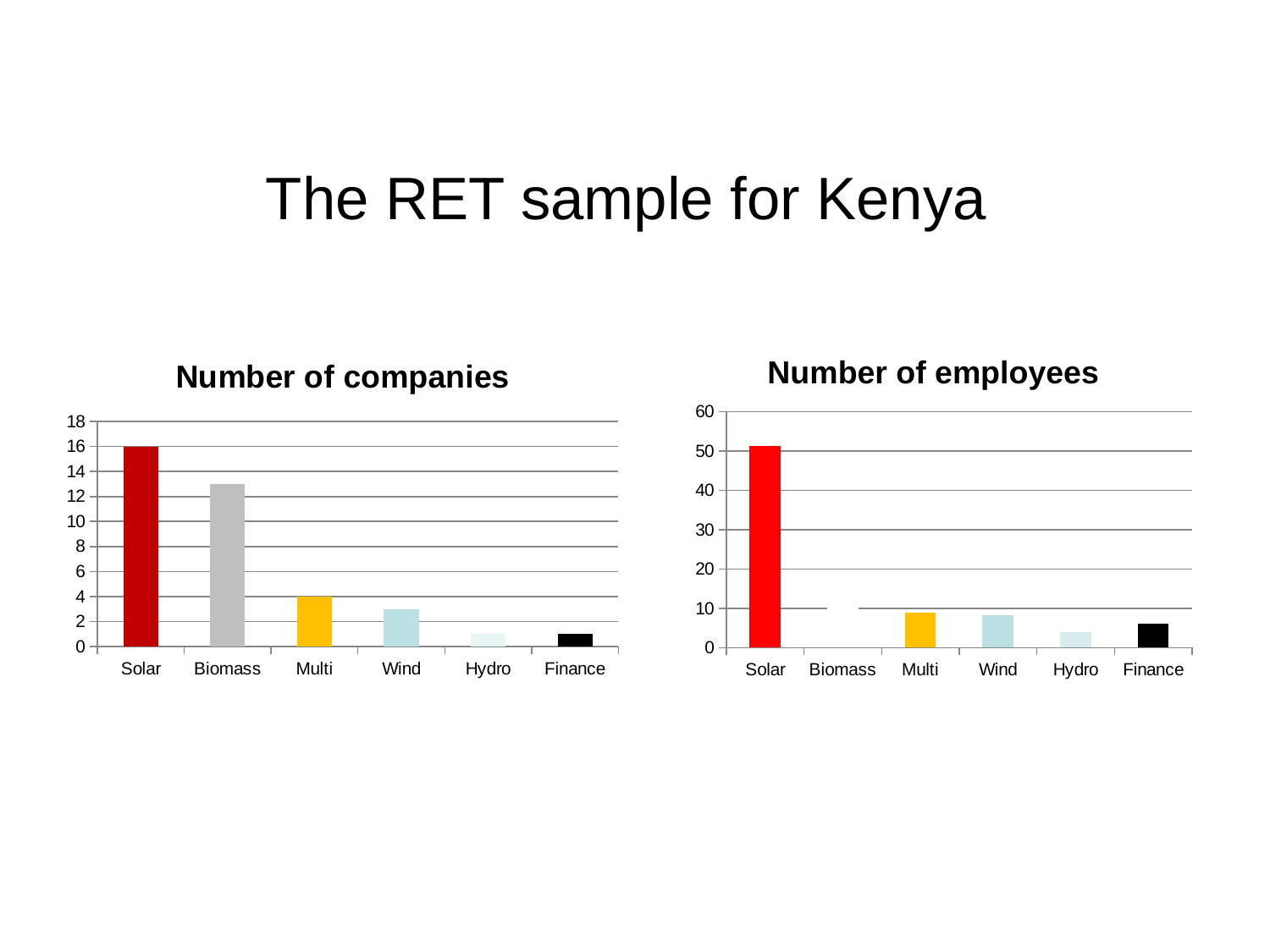
In the "Number of employees" chart, which category has the highest value? Solar In the "Number of companies" chart, is the value for Biomass greater or less than 12? greater In the "Number of companies" chart, what is the value for Multi? 4 What is the title of the chart on the right side of the slide? Number of employees In the "Number of companies" chart, what is the value for Solar? 16 In the "Number of companies" chart, which category has the highest value? Solar In the "Number of employees" chart, is the value for Solar greater or less than 50? greater What kind of chart is the "Number of companies" chart? bar chart In the "Number of employees" chart, is the value for Hydro greater or less than 10? less In the "Number of employees" chart, which is larger, Multi or Hydro? Multi In the "Number of companies" chart, which is larger, Biomass or Multi? Biomass How many categories are shown on the x axis of the "Number of companies" chart? 6